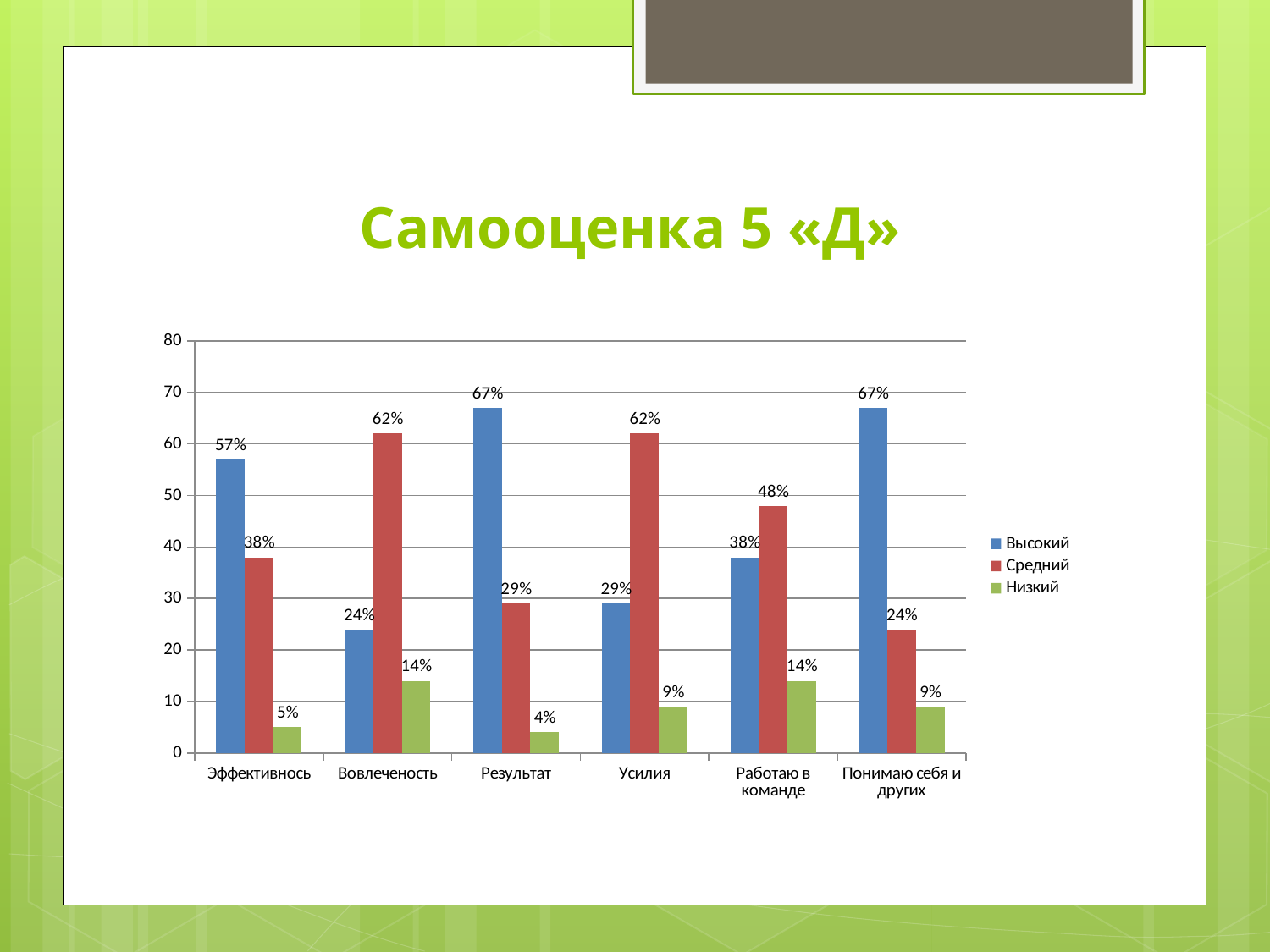
Is the Высокий value for Понимаю себя и других greater or less than 60? greater How many categories are shown on the x axis? 6 What is the value of the Средний series for Работаю в команде? 48% What kind of chart is shown on the slide? Bar chart Which category has the lowest value in the Низкий series? Результат What is the value of the Низкий series for Вовлеченость? 14% Which category has the highest value in the Средний series? Вовлеченость and Усилия (both 62%) What is the value of the Высокий series for Эффективность? 57% What is the difference between the Высокий and Средний values for Результат? 38% What is the title of the slide? Самооценка 5 «Д» How many series does the legend list? 3 Which is larger for Усилия: the Высокий value or the Средний value? Средний